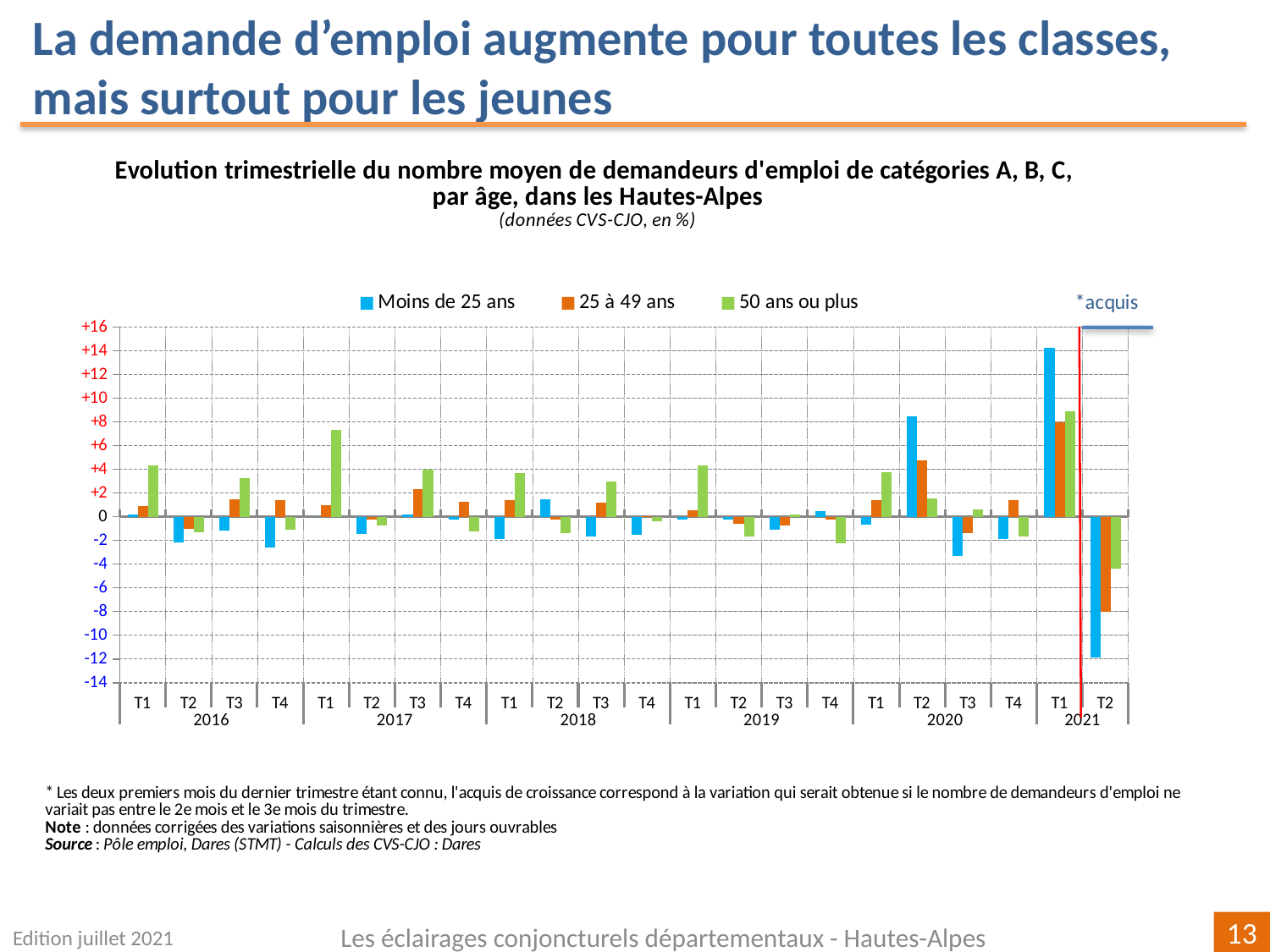
In T2 2021, which is larger: 25 à 49 ans or 50 ans ou plus? 50 ans ou plus In T2 2020, which is larger: Moins de 25 ans or 25 à 49 ans? Moins de 25 ans Is the value for Moins de 25 ans in T1 2021 greater or less than +12? greater Is the value for Moins de 25 ans in T2 2021 greater or less than -10? less Is the value for 50 ans ou plus in T1 2017 greater or less than +6? greater How many series does the legend list? 3 How many quarters are shown along the x axis? 22 Which series and quarter has the lowest bar on the chart? Moins de 25 ans, T2 2021 What kind of chart is shown on the slide? bar chart What colour represents the series Moins de 25 ans in the legend? blue Which series and quarter has the highest bar on the chart? Moins de 25 ans, T1 2021